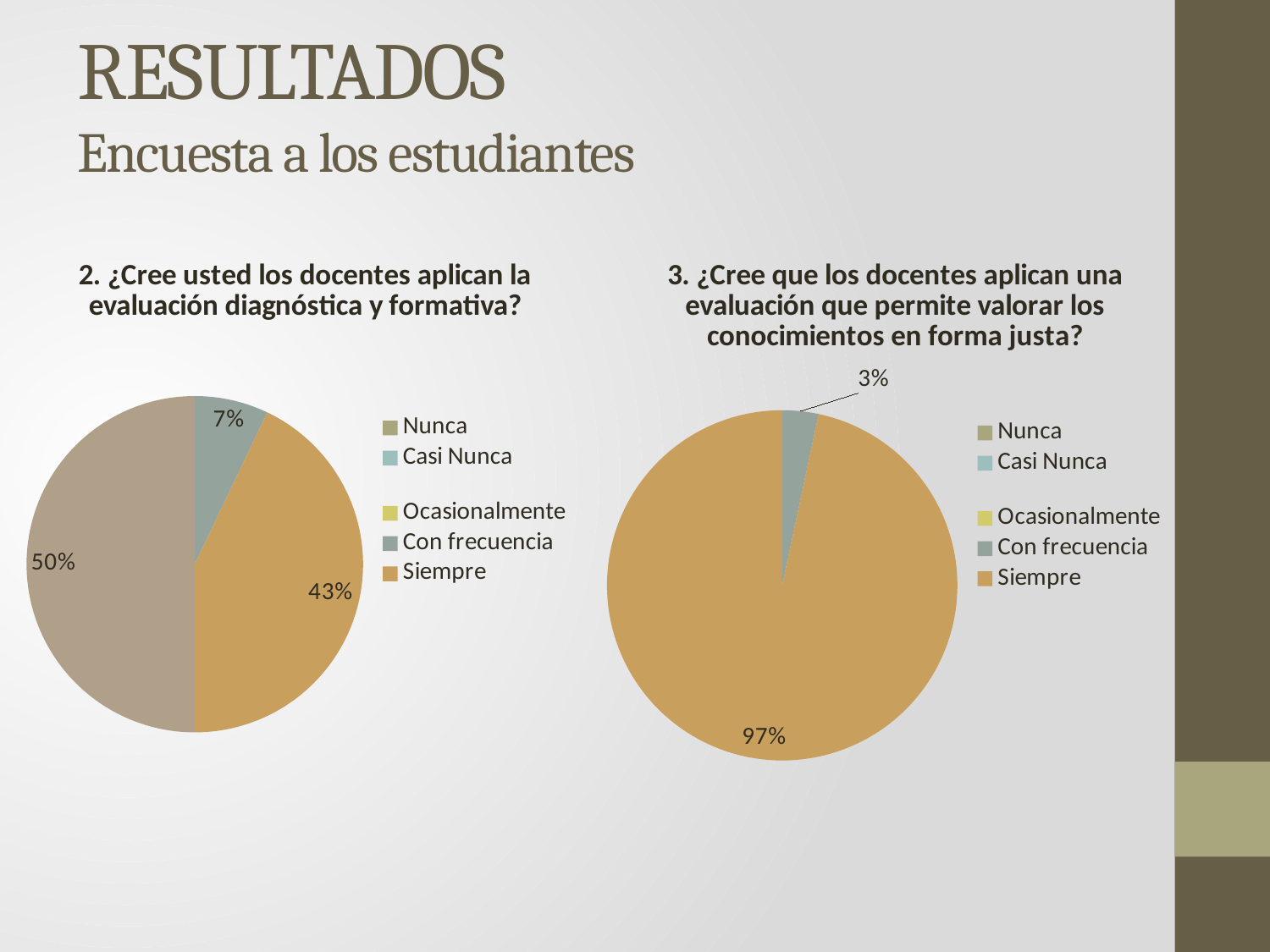
Which chart has the larger Siempre slice, the left chart (question 2) or the right chart (question 3)? The right chart (question 3) In the left chart (question 2), what is the largest slice's percentage? 50% In the left chart (question 2), which category has the smallest slice? Con frecuencia In the right chart (question 3), what is the difference between the Siempre and Con frecuencia slices? 94% In the right chart (question 3), what percentage is shown for Con frecuencia? 3% What kind of charts are shown on the slide? Pie charts In the left chart (question 2), what percentage is shown for the Siempre slice? 43% How many entries does the legend of the right chart (question 3) list? 5 In the left chart (question 2), what percentage is shown for the Con frecuencia slice? 7% In the right chart (question 3), what percentage is shown for Siempre? 97% In the left chart (question 2), what is the difference between the 50% slice and the Siempre slice? 7% In the right chart (question 3), which category has the largest share? Siempre